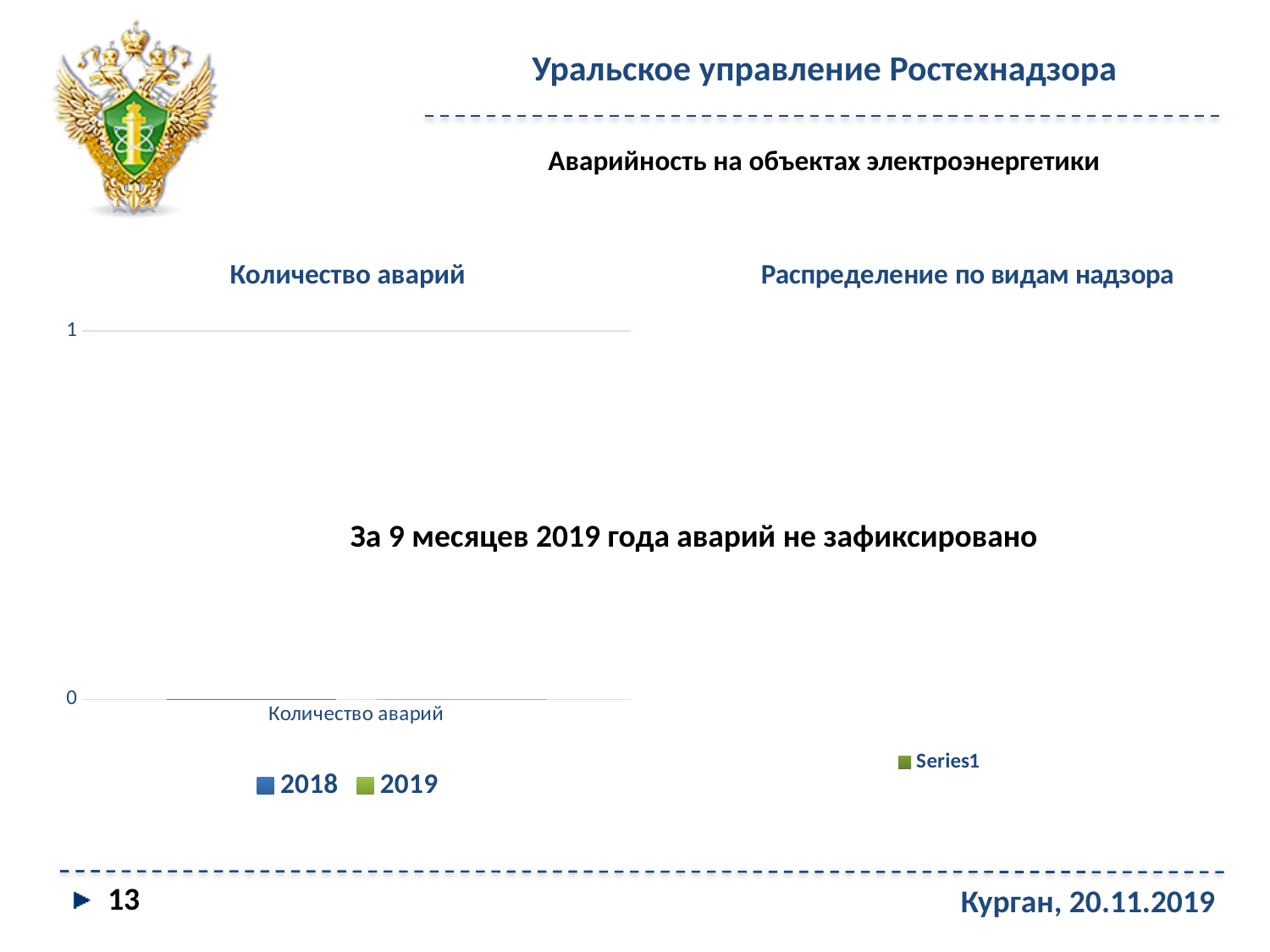
In the chart titled "Количество аварий", how many series does the legend list? 2 In the chart titled "Распределение по видам надзора", how many series does the legend list? 1 In the chart titled "Распределение по видам надзора", what is the name of the series listed in the legend? Series1 In the chart titled "Количество аварий", how many categories are shown on the x axis? 1 In the chart titled "Количество аварий", what is the value for 2019? 0 In the chart titled "Количество аварий", which series is shown in green in the legend? 2019 In the chart titled "Количество аварий", what is the value for 2018? 0 In the chart titled "Количество аварий", what kind of chart is shown? bar chart In the chart titled "Количество аварий", is the value for 2019 greater or less than 1? less In the chart titled "Количество аварий", what is the difference between the 2018 and 2019 values? 0